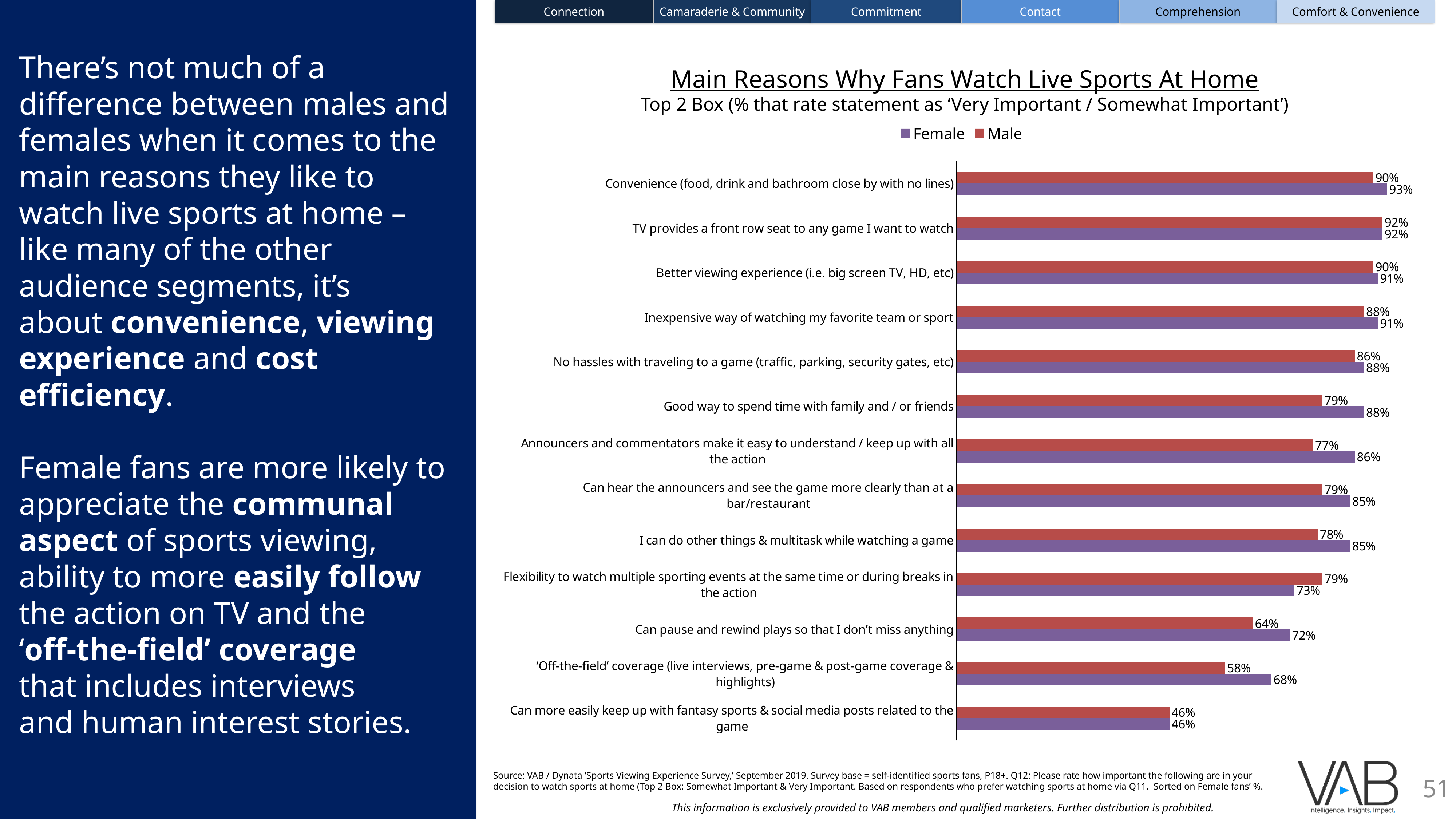
What is the Male value for 'Announcers and commentators make it easy to understand / keep up with all the action'? 77% Which reason has the highest Male value? TV provides a front row seat to any game I want to watch For 'Flexibility to watch multiple sporting events at the same time or during breaks in the action', which is larger, the Male or Female value? Male What is the title of the chart? Main Reasons Why Fans Watch Live Sports At Home Which reason has the lowest Female value? Can more easily keep up with fantasy sports & social media posts related to the game What is the difference between the Female and Male values for ''Off-the-field' coverage (live interviews, pre-game & post-game coverage & highlights)'? 10% What is the difference between the Female and Male values for 'Good way to spend time with family and / or friends'? 9% What kind of chart is shown on the slide? Bar chart What is the Male value for 'Can pause and rewind plays so that I don't miss anything'? 64% What is the Female value for 'Convenience (food, drink and bathroom close by with no lines)'? 93% How many reasons (categories) are plotted in the chart? 13 How many series does the legend list? 2